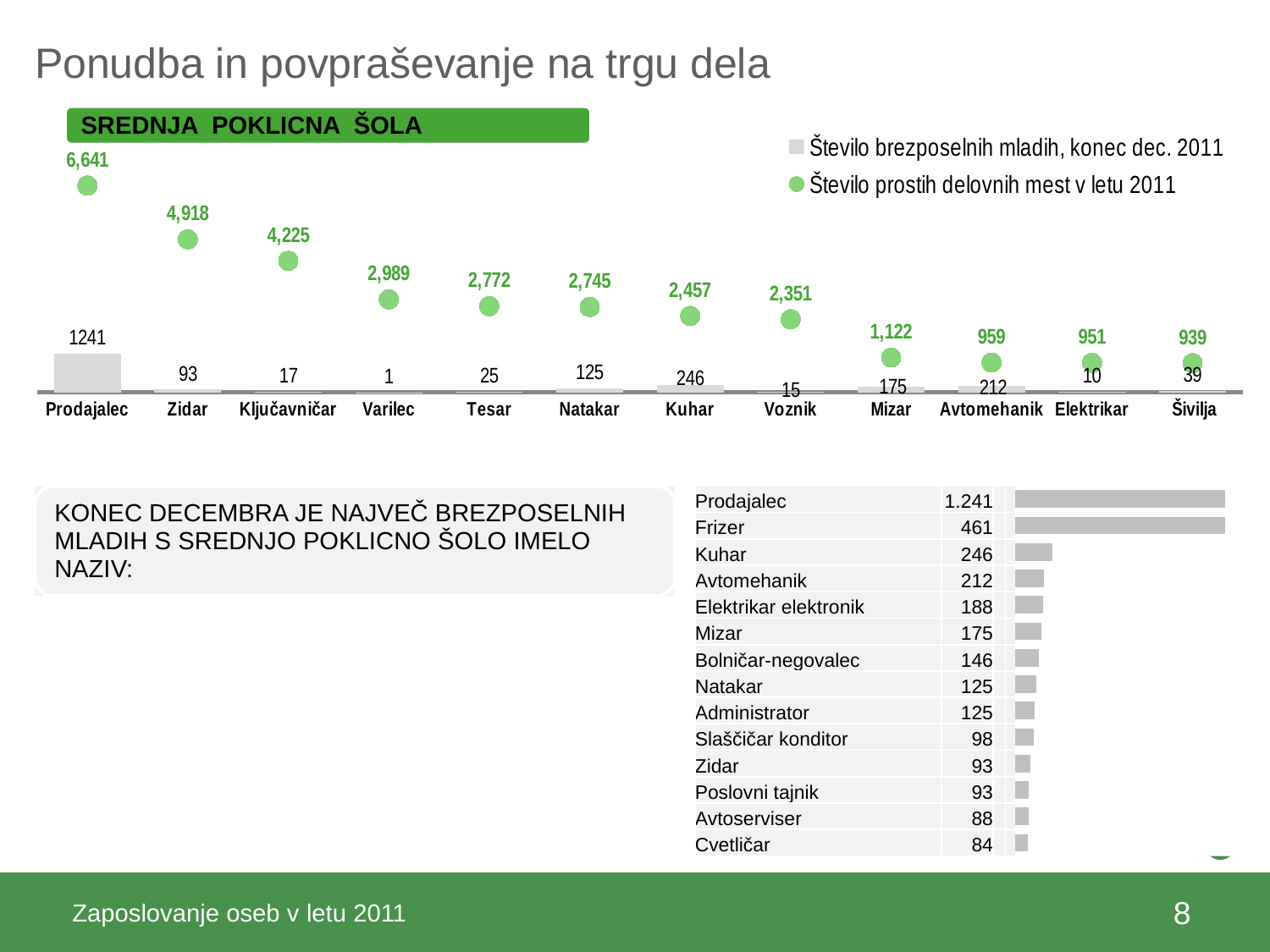
How many categories are shown on the x axis of the chart titled SREDNJA POKLICNA ŠOLA? 12 In the chart titled SREDNJA POKLICNA ŠOLA, what is the value of Število brezposelnih mladih, konec dec. 2011 for Varilec? 1 In the chart titled SREDNJA POKLICNA ŠOLA, which category has the lowest value of Število prostih delovnih mest v letu 2011? Šivilja How many series does the legend of the chart titled SREDNJA POKLICNA ŠOLA list? 2 In the chart titled SREDNJA POKLICNA ŠOLA, what is the value of Število prostih delovnih mest v letu 2011 for Mizar? 1,122 In the chart titled SREDNJA POKLICNA ŠOLA, what is the difference between Število prostih delovnih mest v letu 2011 for Zidar and for Ključavničar? 693 In the chart titled SREDNJA POKLICNA ŠOLA, which is larger: Število brezposelnih mladih, konec dec. 2011 for Avtomehanik or for Mizar? Avtomehanik In the chart titled SREDNJA POKLICNA ŠOLA, what is the value of Število brezposelnih mladih, konec dec. 2011 for Kuhar? 246 In the chart titled SREDNJA POKLICNA ŠOLA, which category has the highest value of Število prostih delovnih mest v letu 2011? Prodajalec In the chart titled SREDNJA POKLICNA ŠOLA, do the values of Število prostih delovnih mest v letu 2011 rise or fall from left to right along the x axis? fall In the chart titled SREDNJA POKLICNA ŠOLA, what is the value of Število prostih delovnih mest v letu 2011 for Prodajalec? 6,641 In the chart titled SREDNJA POKLICNA ŠOLA, which category has the highest value of Število brezposelnih mladih, konec dec. 2011? Prodajalec